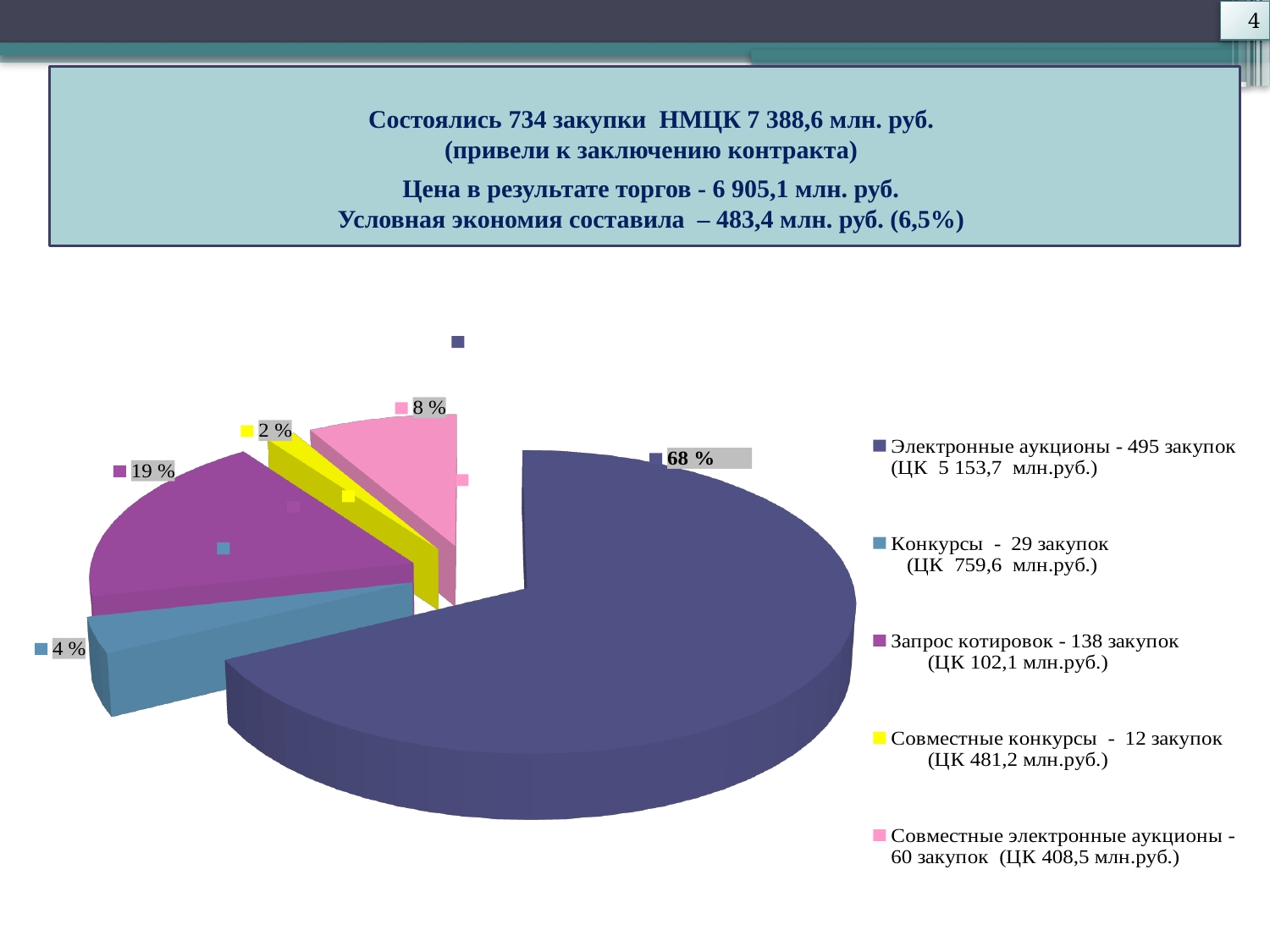
Which category has the smallest slice of the pie? Совместные конкурсы What colour is the Запрос котировок slice? purple Which slice is larger: Конкурсы or Совместные электронные аукционы? Совместные электронные аукционы What share of the pie does Совместные конкурсы have? 2 % What kind of chart is shown on the slide? pie chart What share of the pie does Совместные электронные аукционы have? 8 % What share of the pie does Электронные аукционы have? 68 % Which category has the largest slice of the pie? Электронные аукционы What share of the pie does Запрос котировок have? 19 % According to the legend, how many purchases (закупок) does the Конкурсы entry list? 29 закупок What is the difference in percentage points between the Электронные аукционы slice and the Запрос котировок slice? 49 % How many slices does the pie chart have? 5